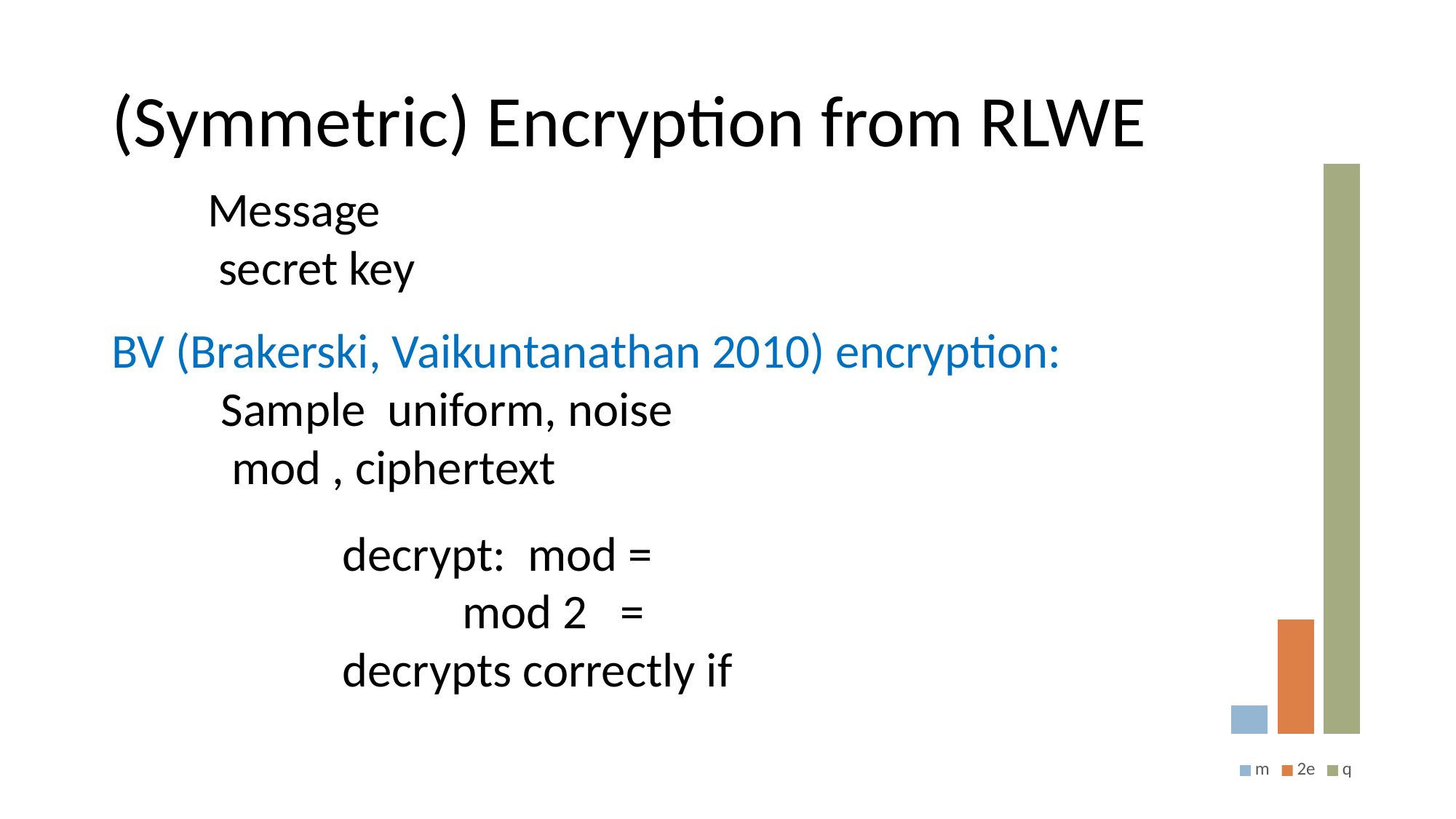
What are the three entries listed in the chart legend, in order? m, 2e, q Which bar is taller, q or 2e? q How many series does the chart legend list? 3 How many bars are plotted in the chart? 3 What colour is the bar for the series q? green Which bar is taller, 2e or m? 2e What kind of chart is shown on the right side of the slide? bar chart Which series has the tallest bar in the chart? q Which series has the shortest bar in the chart? m